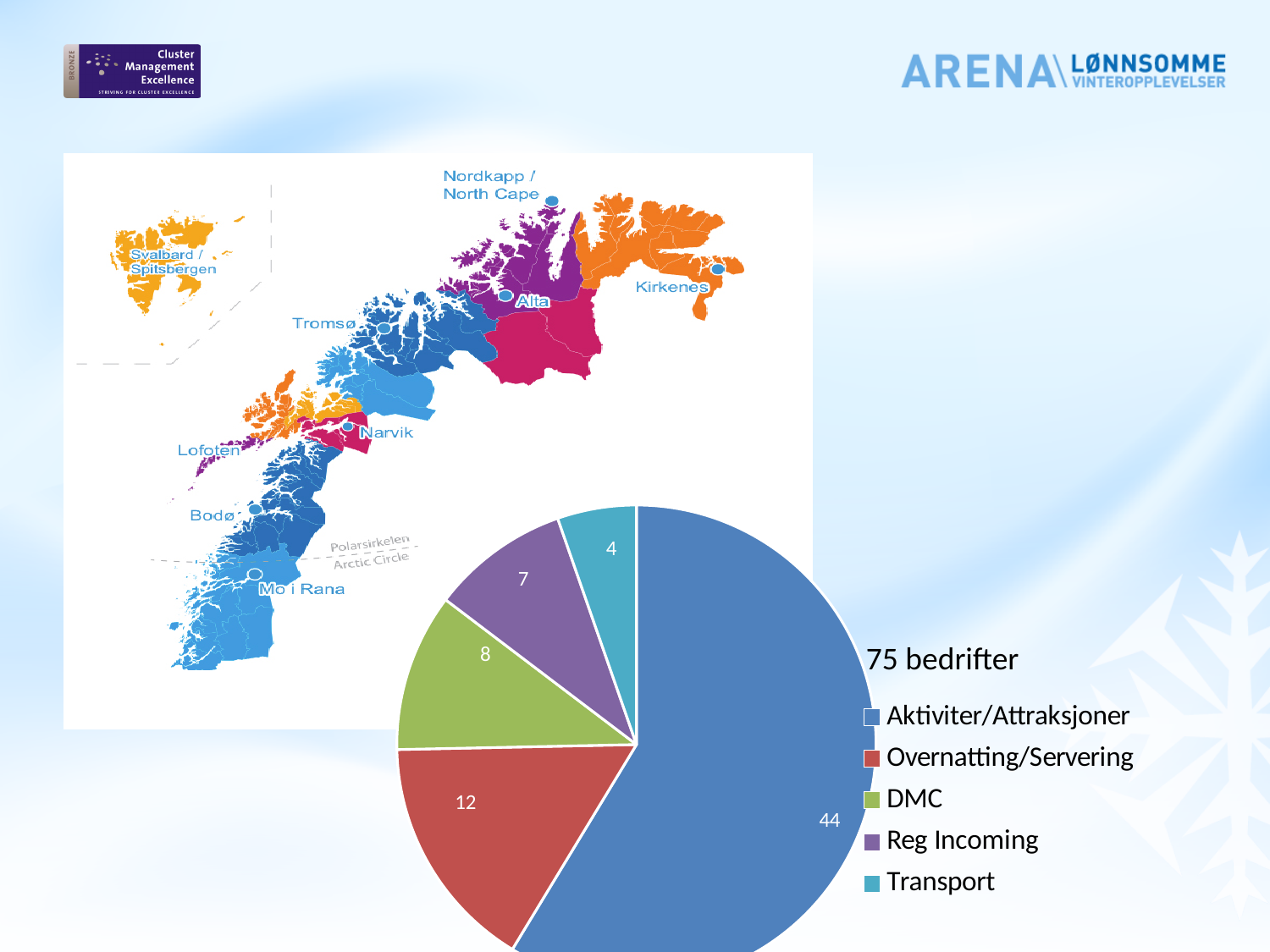
What is the value for Aktiviter/Attraksjoner in the pie chart? 44 Which is larger in the pie chart, DMC or Reg Incoming? DMC What is the difference between the values for Aktiviter/Attraksjoner and Overnatting/Servering? 32 What is the value for Reg Incoming in the pie chart? 7 Which category has the largest slice in the pie chart? Aktiviter/Attraksjoner What is the value for Transport in the pie chart? 4 What is the value for Overnatting/Servering in the pie chart? 12 How many categories does the pie chart have? 5 What kind of chart is shown on the slide? pie chart What share of the pie does Overnatting/Servering represent? 16% Which category has the smallest slice in the pie chart? Transport What is the value for DMC in the pie chart? 8